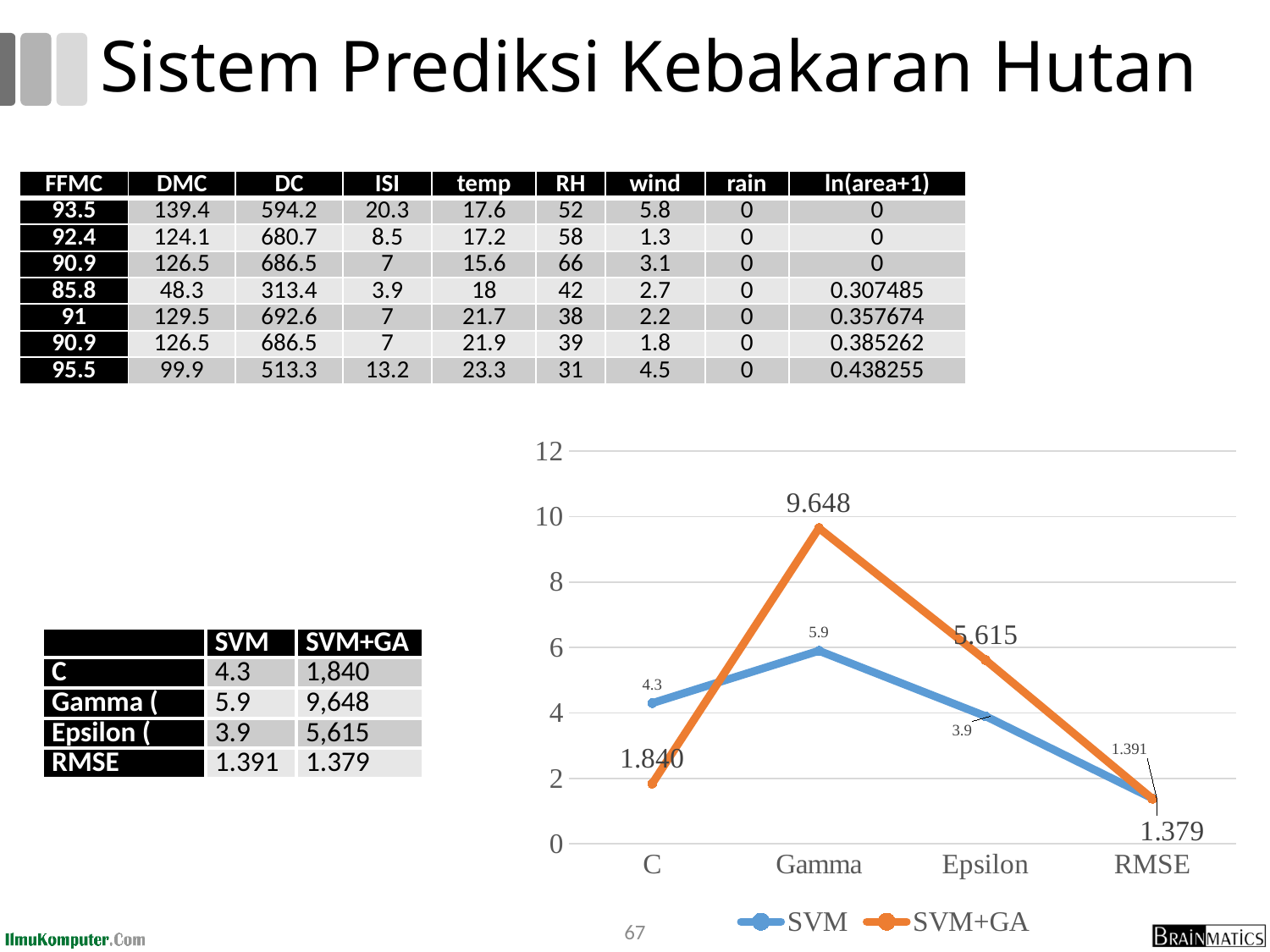
Which series has the larger value for C, SVM or SVM+GA? SVM What type of chart is shown on the slide? line chart What is the value of the SVM series for RMSE? 1.391 Is the SVM+GA value for Gamma greater or less than 8? greater Which two series are listed in the chart legend? SVM and SVM+GA What is the value of the SVM+GA series for Gamma? 9.648 What is the value of the SVM+GA series for Epsilon? 5.615 How many series does the chart legend list? 2 For which category does the SVM+GA series reach its highest value? Gamma For which category does the SVM series have its lowest value? RMSE How many categories are plotted along the x axis of the chart? 4 What is the value of the SVM series for C? 4.3